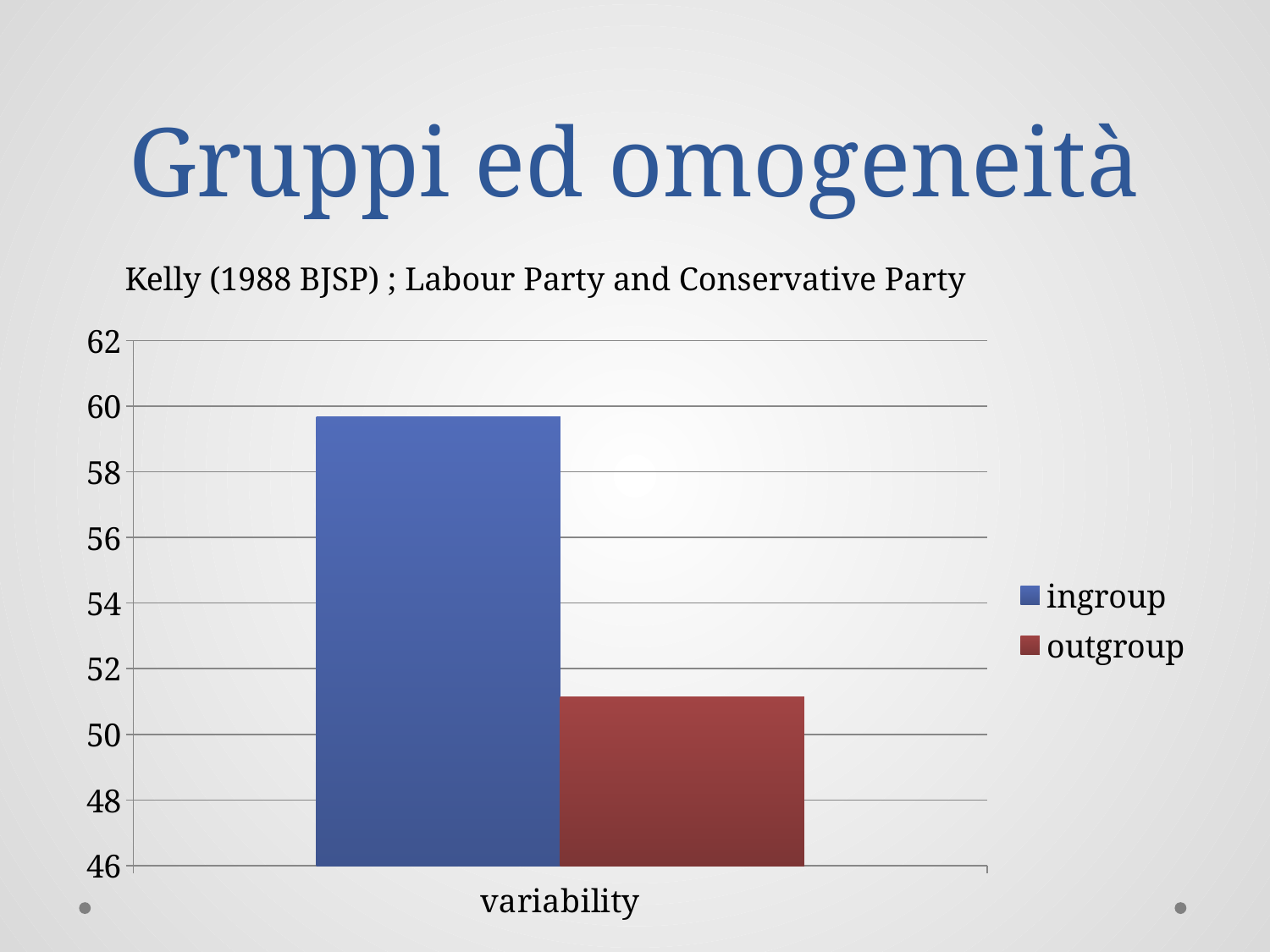
What is the label of the category on the x axis? variability Is the value for outgroup greater or less than 52? less Is the value for outgroup greater or less than 50? greater Is the value for ingroup greater or less than 58? greater How many series does the legend list? 2 How many categories are shown on the x axis? 1 Which series has the lowest value in the chart? outgroup Which series has the higher value for variability, ingroup or outgroup? ingroup What kind of chart is shown on the slide? bar chart What colour is the bar for the outgroup series? red